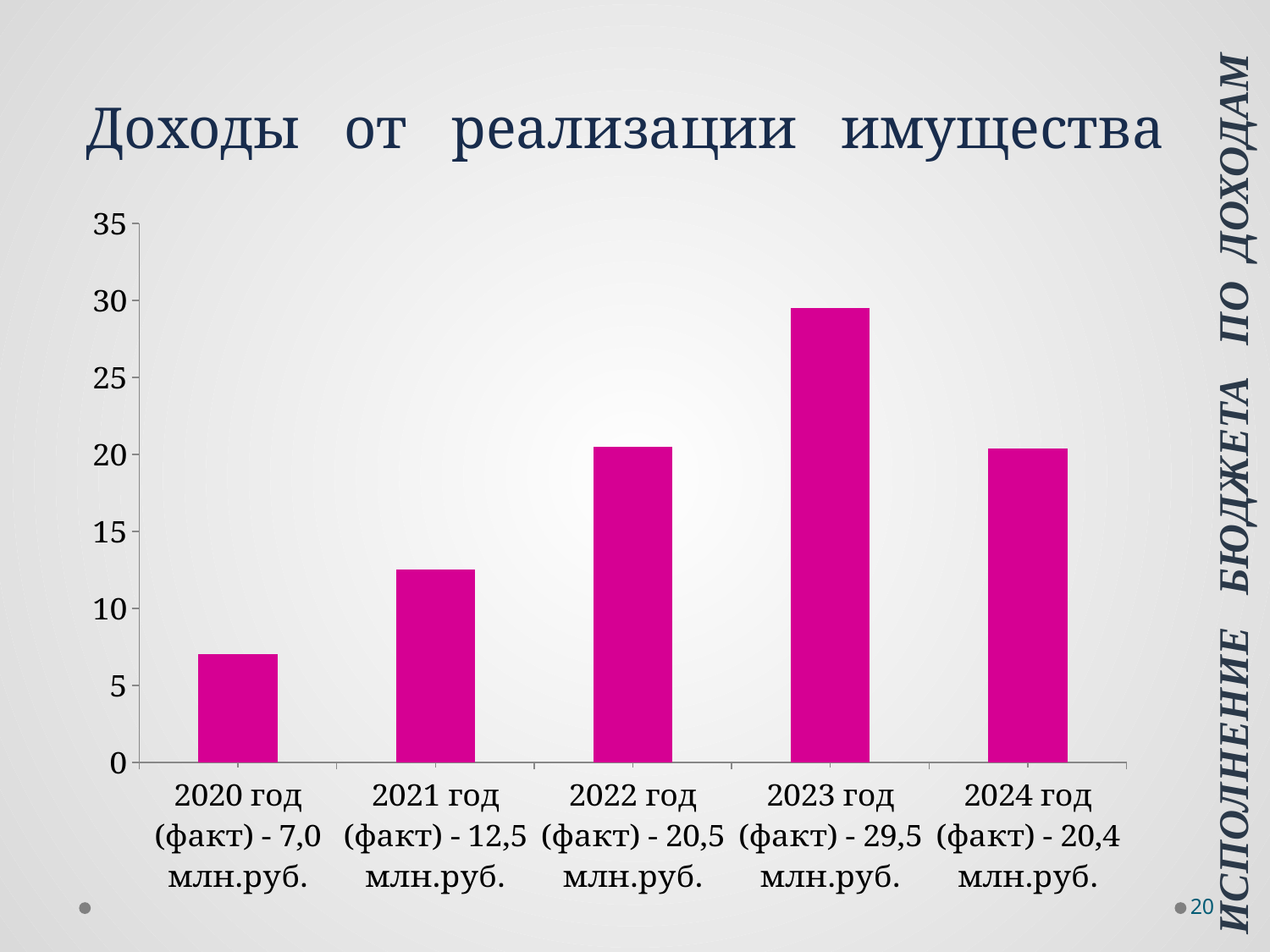
What is the value for 2024 год (факт)? 20,4 млн.руб. What kind of chart is shown on the slide? bar chart Which year has the highest value? 2023 год How many years are shown on the chart? 5 Which is larger, the value for 2021 год or the value for 2023 год? 2023 год What is the difference between the values for 2022 год and 2021 год? 8,0 млн.руб. Is the value for 2021 год greater or less than 15? less What is the value for 2023 год (факт)? 29,5 млн.руб. What is the difference between the values for 2023 год and 2020 год? 22,5 млн.руб. Which year has the lowest value? 2020 год What is the value for 2020 год (факт)? 7,0 млн.руб. What is the title of the chart? Доходы от реализации имущества